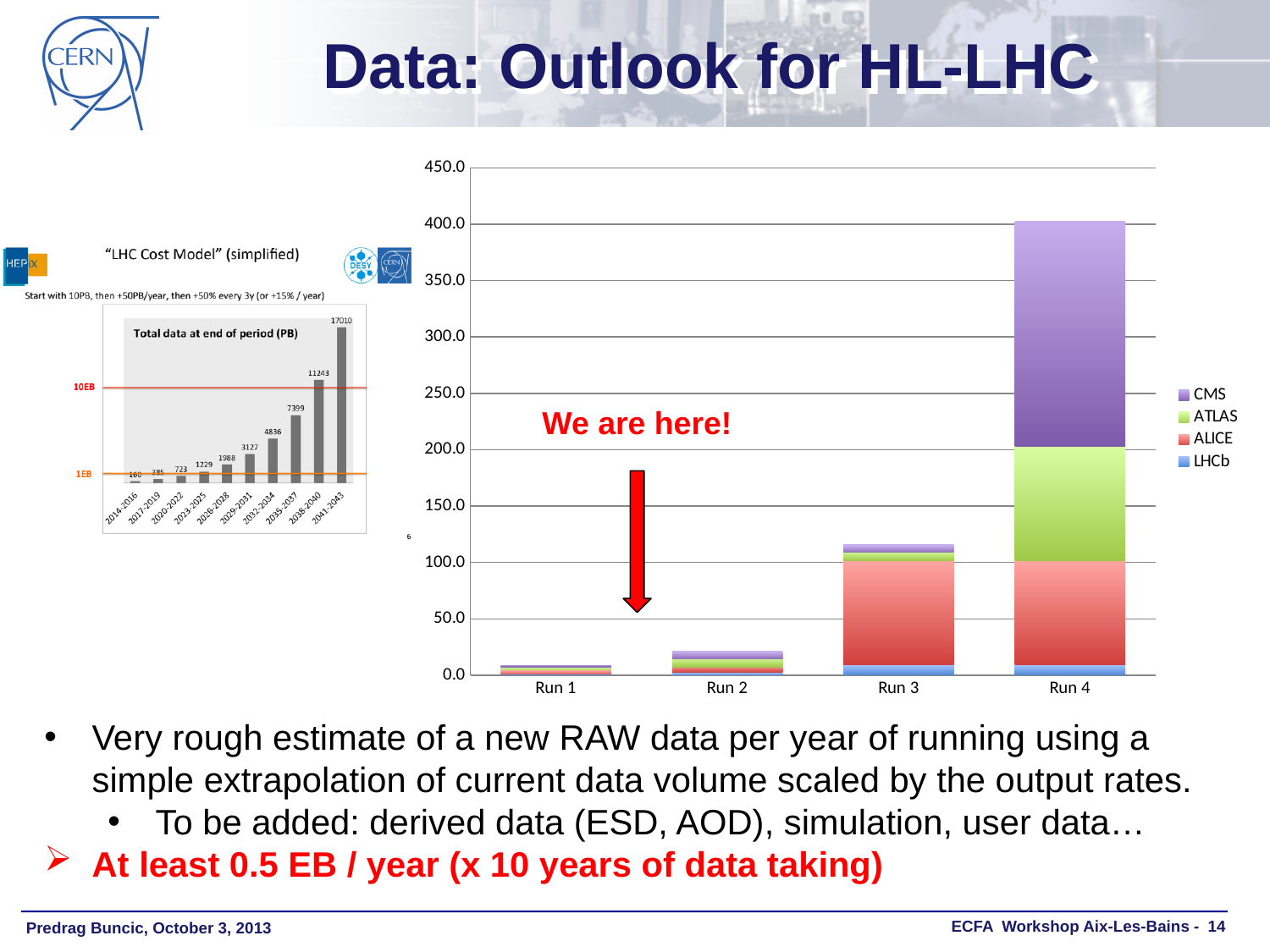
In the large stacked bar chart on the right, is the total for Run 3 greater or less than 100.0? greater In the large stacked bar chart on the right, which run has the shortest bar? Run 1 In the large stacked bar chart on the right, which run has the tallest bar? Run 4 In the large stacked bar chart on the right, is the total for Run 2 greater or less than 50.0? less What type of chart is the large chart on the right? stacked bar chart In the large stacked bar chart on the right, do the bar totals rise or fall from Run 1 to Run 4? rise In the large stacked bar chart on the right, is the total for Run 4 greater or less than 350.0? greater In the small chart titled "Total data at end of period (PB)", what is the value for 2014-2016? 160 In the large stacked bar chart on the right, which series is shown in purple? CMS In the small chart titled "Total data at end of period (PB)", what is the value for 2041-2043? 17010 In the small chart titled "Total data at end of period (PB)", how many periods are shown on the x axis? 10 In the large stacked bar chart on the right, how many series does the legend list? 4